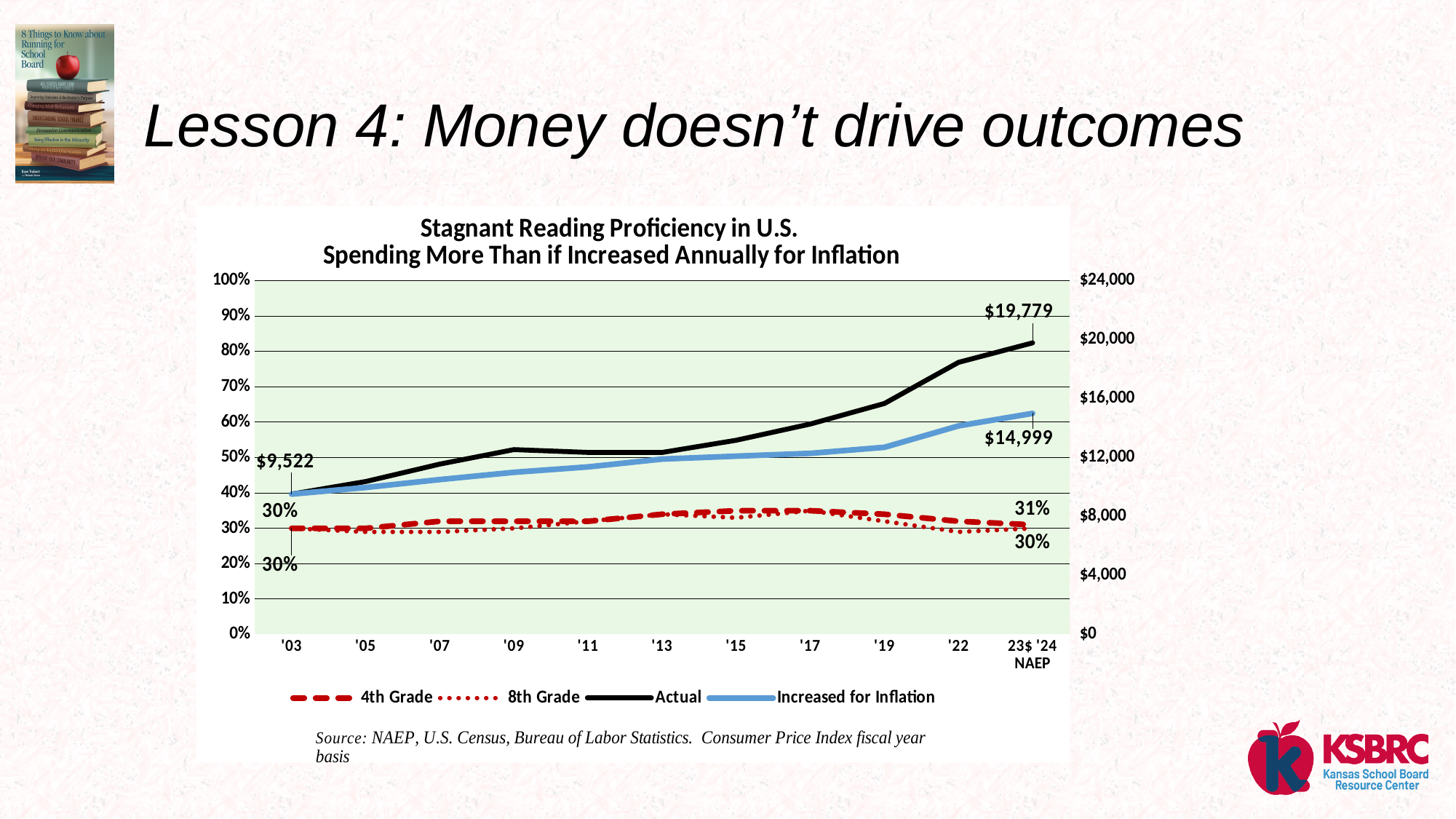
What kind of chart is shown on the slide? Line chart Is the Actual spending value at '22 greater or less than $16,000? greater How many series does the legend list? 4 What is the 4th Grade reading proficiency at the end of the chart? 31% At the end of the chart, which is larger: Actual spending or Increased for Inflation spending? Actual What is the difference between the Actual spending and the Increased for Inflation spending at the end of the chart? $4,780 What is the value of the Increased for Inflation line at the end of the chart? $14,999 What is the 8th Grade reading proficiency at the end of the chart? 30% By how much did Actual spending increase from '03 to the end of the chart? $10,257 What is the value of the Actual spending line at the end of the chart? $19,779 What was the spending value labeled at '03? $9,522 What was the 4th Grade reading proficiency in '03? 30%